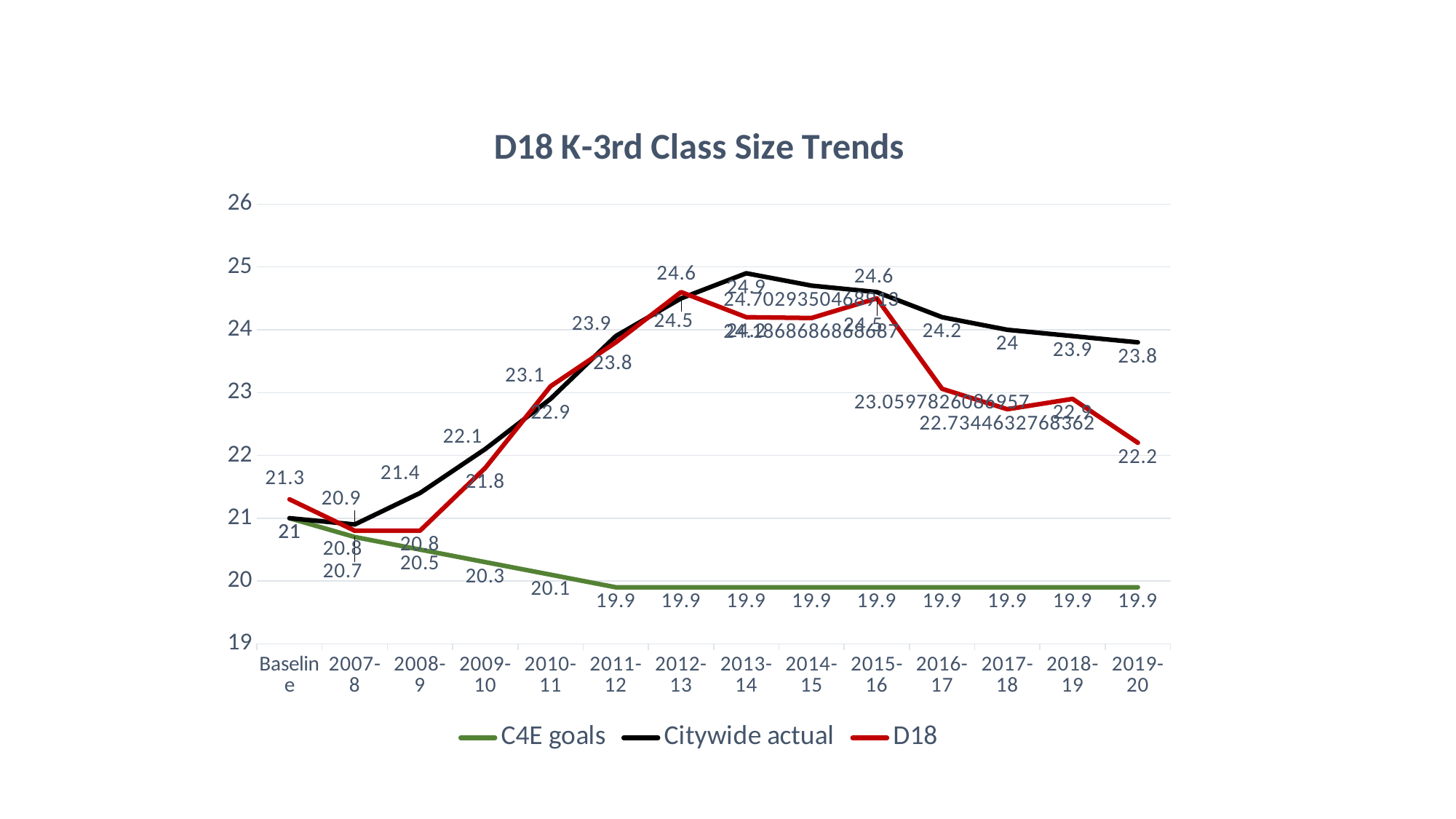
What is the title of the chart? D18 K-3rd Class Size Trends What is the D18 value for 2019-20? 22.2 What is the difference between the Citywide actual value in 2013-14 and in 2019-20? 1.1 Do the C4E goals values rise or fall from Baseline to 2011-12? fall What is the D18 value at Baseline? 21.3 How many categories are shown along the x axis? 14 Is the D18 value for 2017-18 greater or less than 23? less What is the Citywide actual value for 2013-14? 24.9 In 2019-20, which is larger: the Citywide actual value or the D18 value? Citywide actual What kind of chart is shown on the slide? line chart In which year does the Citywide actual series reach its highest value? 2013-14 How many series does the legend list? 3